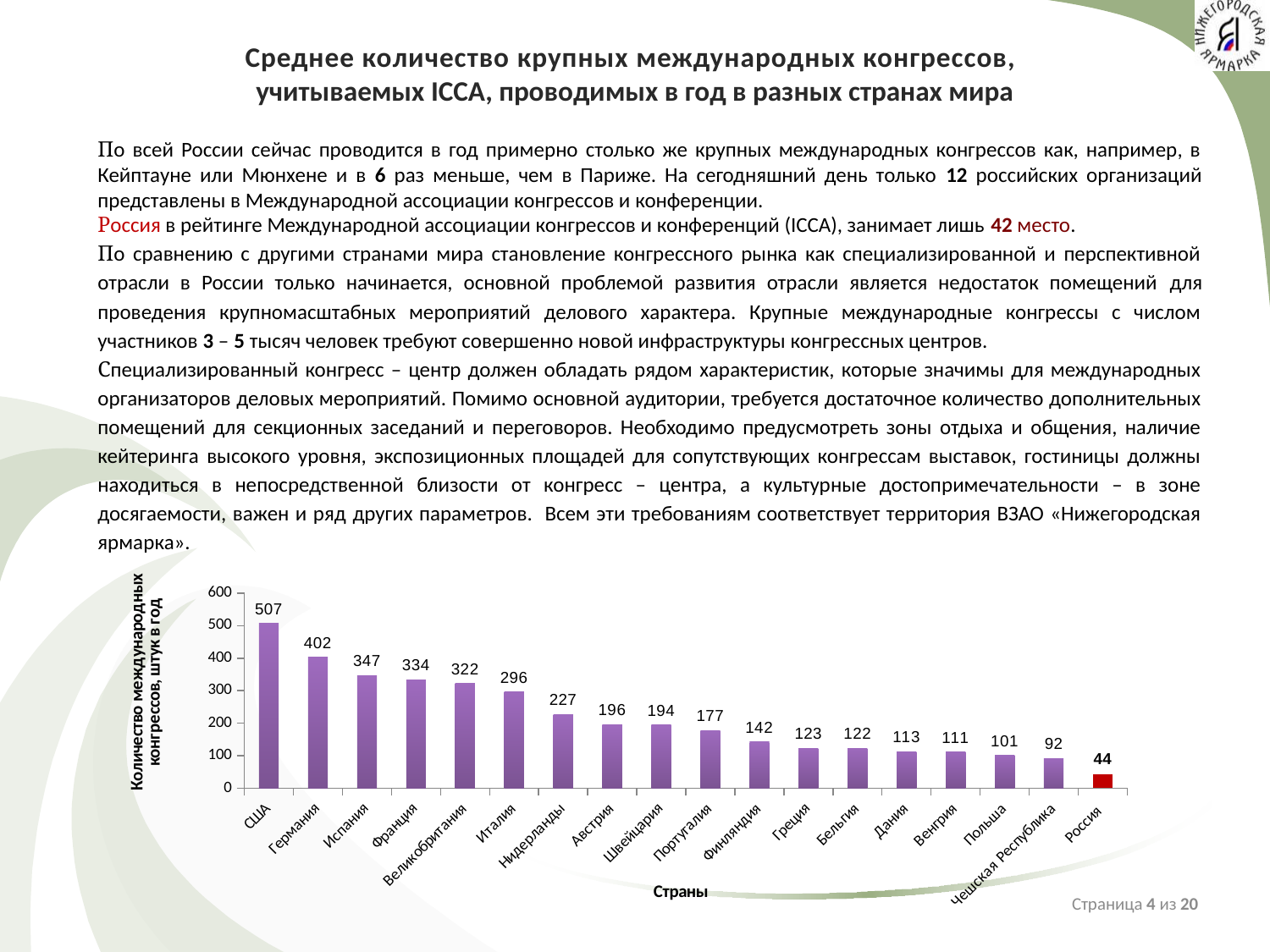
Which is larger, the value for Италия or the value for Австрия? Италия How many countries are shown in the chart? 18 What is the difference between the values for Германия and Испания? 55 Which country has the lowest value in the chart? Россия What is the value for Нидерланды in the chart? 227 What is the difference between the values for Франция and Россия? 290 Is the value for Португалия greater or less than 200? less What kind of chart is shown on the slide? bar chart What is the label of the vertical axis of the chart? Количество международных конгрессов, штук в год What is the value for Россия in the chart? 44 Which country has the highest value in the chart? США What is the value for США in the chart? 507